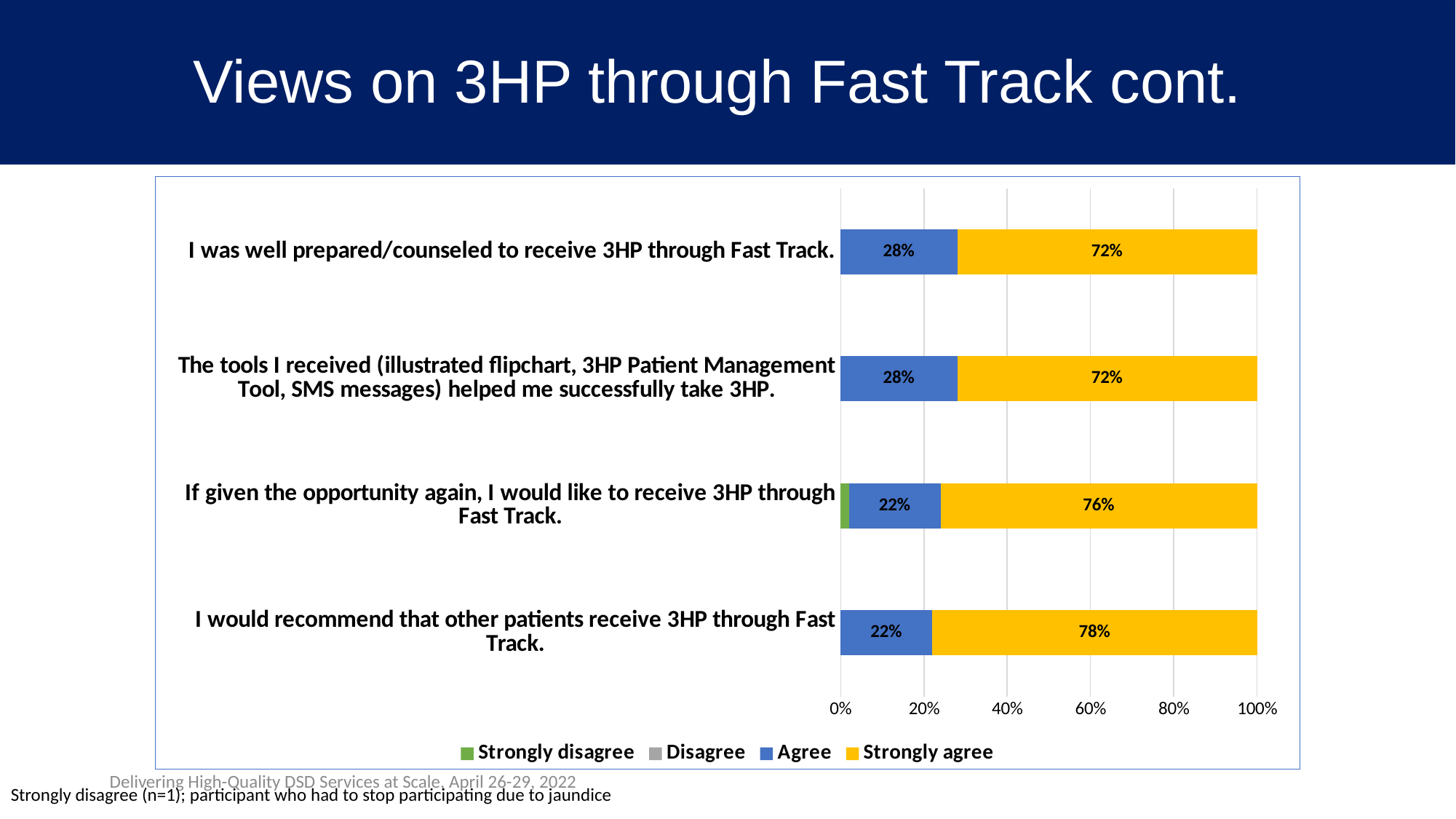
Which statement is the only one with a Strongly disagree segment in its bar? If given the opportunity again, I would like to receive 3HP through Fast Track. For "The tools I received ... helped me successfully take 3HP.", how much larger is the Strongly agree share than the Agree share? 44 percentage points Which statement has the highest Strongly agree percentage? I would recommend that other patients receive 3HP through Fast Track. What percentage of respondents agreed (not strongly) with "I was well prepared/counseled to receive 3HP through Fast Track."? 28% What is the difference in Strongly agree percentage between "I would recommend that other patients receive 3HP through Fast Track." and "I was well prepared/counseled to receive 3HP through Fast Track."? 6 percentage points Which has a larger Strongly agree percentage: "If given the opportunity again, I would like to receive 3HP through Fast Track." or "I was well prepared/counseled to receive 3HP through Fast Track."? If given the opportunity again, I would like to receive 3HP through Fast Track. How many response categories does the legend list? 4 What kind of chart is shown on the slide? Stacked horizontal bar chart What percentage of respondents strongly agreed with "I would recommend that other patients receive 3HP through Fast Track."? 78% Is the Strongly agree value for "I would recommend that other patients receive 3HP through Fast Track." greater or less than 60%? greater What is the Strongly agree value for "If given the opportunity again, I would like to receive 3HP through Fast Track."? 76% How many statements are shown in the chart? 4